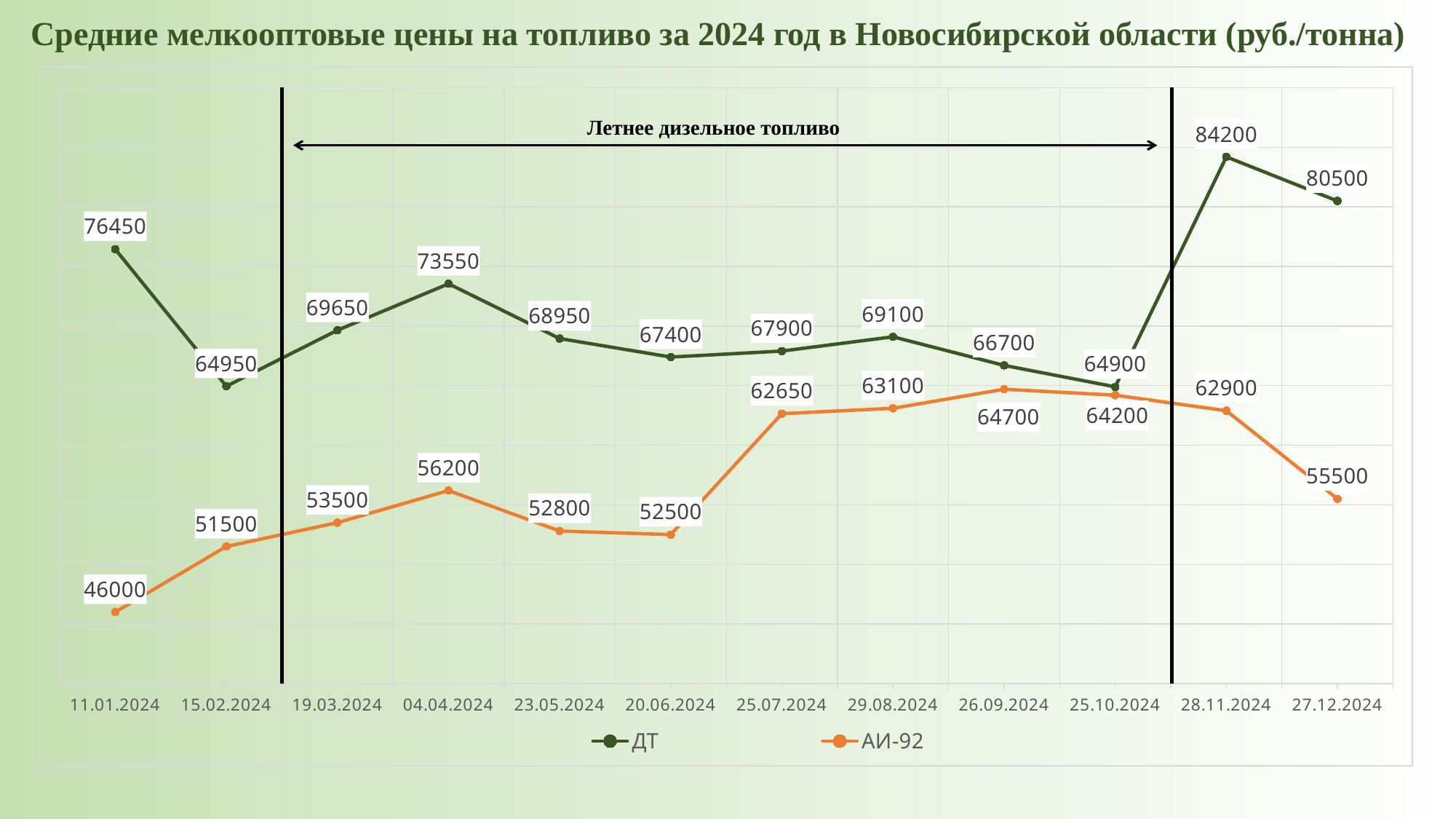
On which date is the АИ-92 value lowest? 11.01.2024 Which is larger: the ДТ value on 15.02.2024 or the ДТ value on 19.03.2024? 19.03.2024 On which date is the АИ-92 value highest? 26.09.2024 What is the ДТ value on 28.11.2024? 84200 How many dates are plotted on the x axis? 12 What is the difference between the ДТ and АИ-92 values on 11.01.2024? 30450 What is the ДТ value on 04.04.2024? 73550 On which date is the ДТ value highest? 28.11.2024 What is the АИ-92 value on 27.12.2024? 55500 How many series does the legend list? 2 What kind of chart is shown on the slide? line chart What is the АИ-92 value on 11.01.2024? 46000